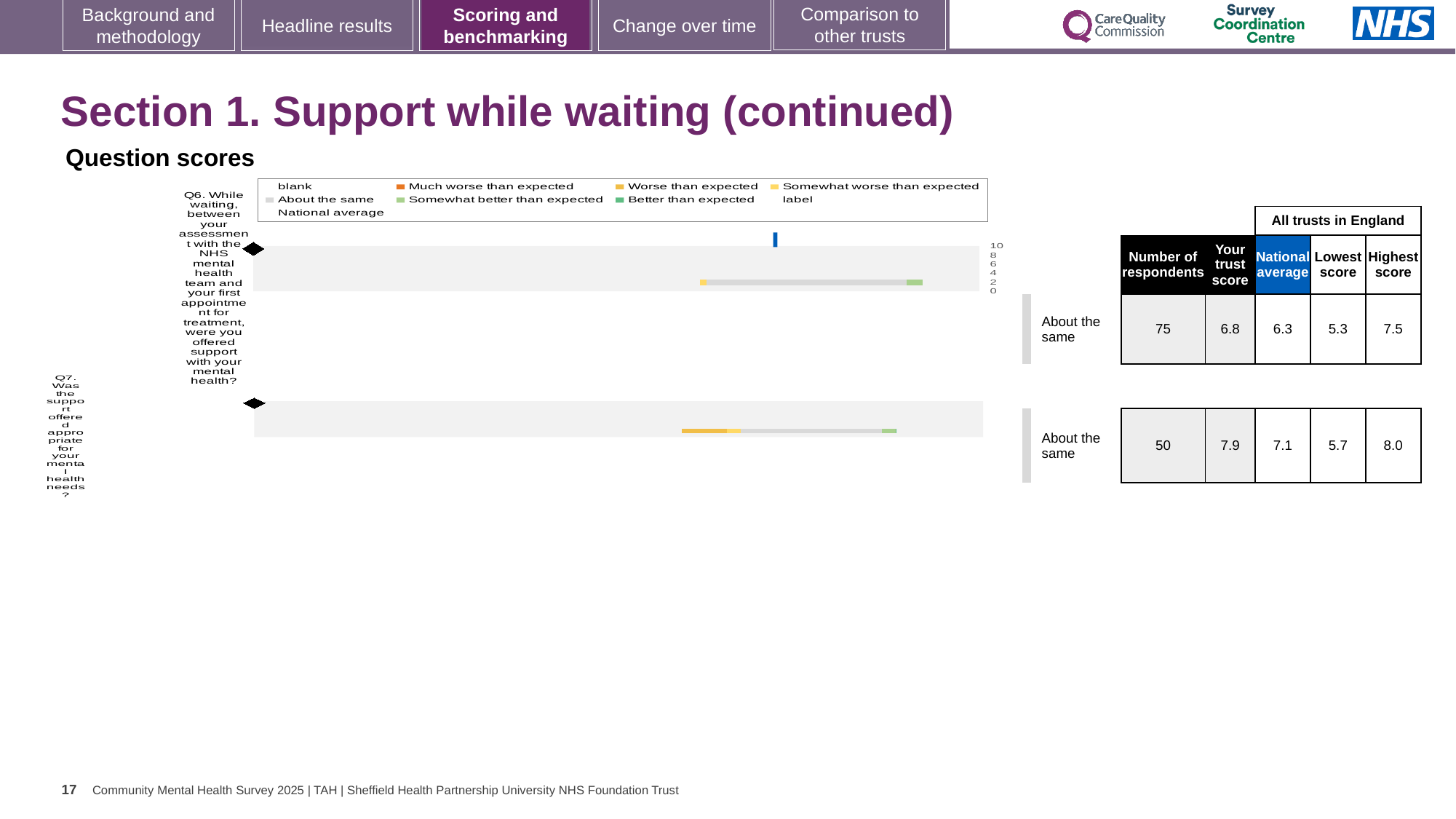
Which legend entry in the question scores chart is shown in dark green? Better than expected How many questions (categories) are plotted in the question scores chart? 2 What is the national average score for Q7 in the question scores table? 7.1 What kind of chart is used to show the question scores for Q6 and Q7? bar chart How many respondents answered Q7? 50 What is the difference between the highest and lowest scores across all trusts in England for Q6? 2.2 Which legend entry in the question scores chart is shown in orange? Much worse than expected How is the trust's score for Q6 categorised relative to expectation? About the same What is the difference between the trust score and the national average for Q7? 0.8 Which question has the higher trust score, Q6 or Q7? Q7 What is the trust score for Q6 in the question scores table? 6.8 What is the highest score across all trusts in England for Q6? 7.5